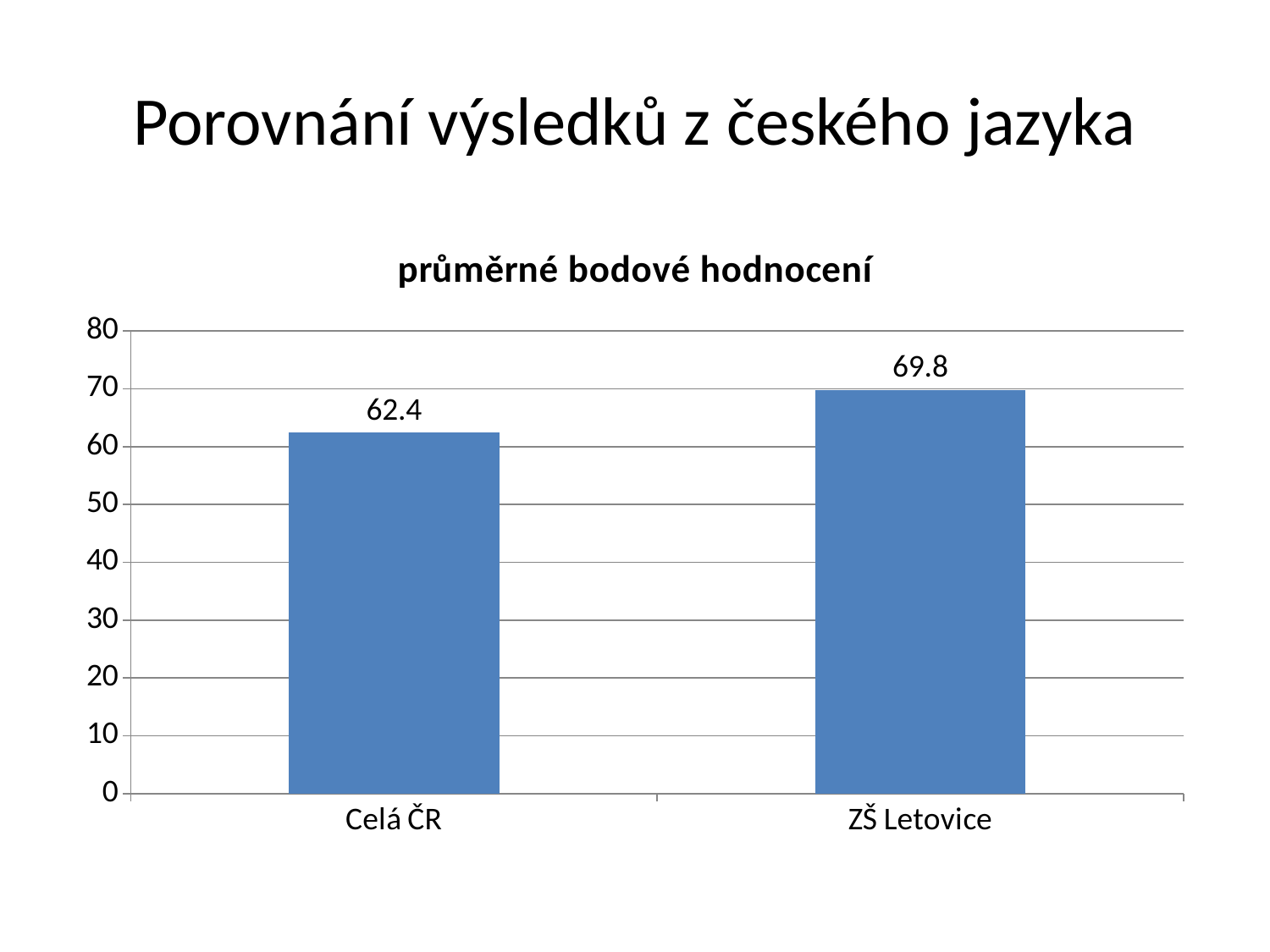
What is the value for Celá ČR? 62.4 Which category has the highest value? ZŠ Letovice Is the value for Celá ČR greater or less than 60? greater What kind of chart is shown on the slide? bar chart What is the title of the chart? průměrné bodové hodnocení Which category has the lowest value? Celá ČR What is the value for ZŠ Letovice? 69.8 What is the highest value shown on the y axis? 80 What is the difference between the values for ZŠ Letovice and Celá ČR? 7.4 Is the value for ZŠ Letovice greater or less than 70? less Which is larger, the value for Celá ČR or the value for ZŠ Letovice? ZŠ Letovice How many categories are shown on the x axis? 2